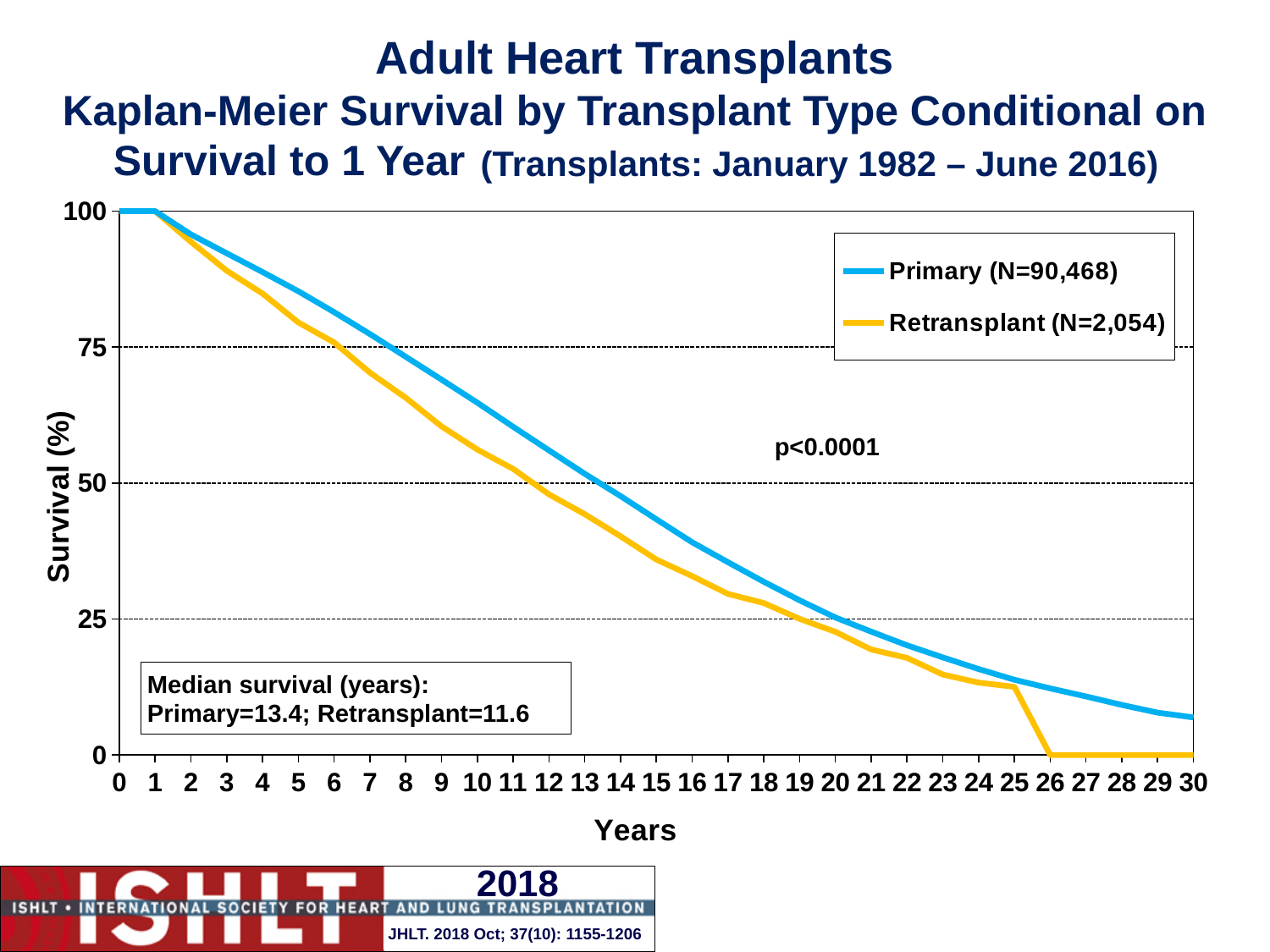
What is the Retransplant survival (%) at 28 years? 0 What is the N for the Retransplant series shown in the legend? 2,054 What is the median survival in years for Primary transplants? 13.4 What is the N for the Primary series shown in the legend? 90,468 What kind of chart is shown on the slide? line chart What is the median survival in years for Retransplants? 11.6 Is the Retransplant survival at 5 years greater or less than 75? greater Do the survival curves rise or fall as years increase? fall Is the Primary survival at 15 years greater or less than 50? less What is the difference in median survival (years) between Primary and Retransplant? 1.8 How many series does the legend list? 2 Which series has the higher survival at 10 years, Primary or Retransplant? Primary